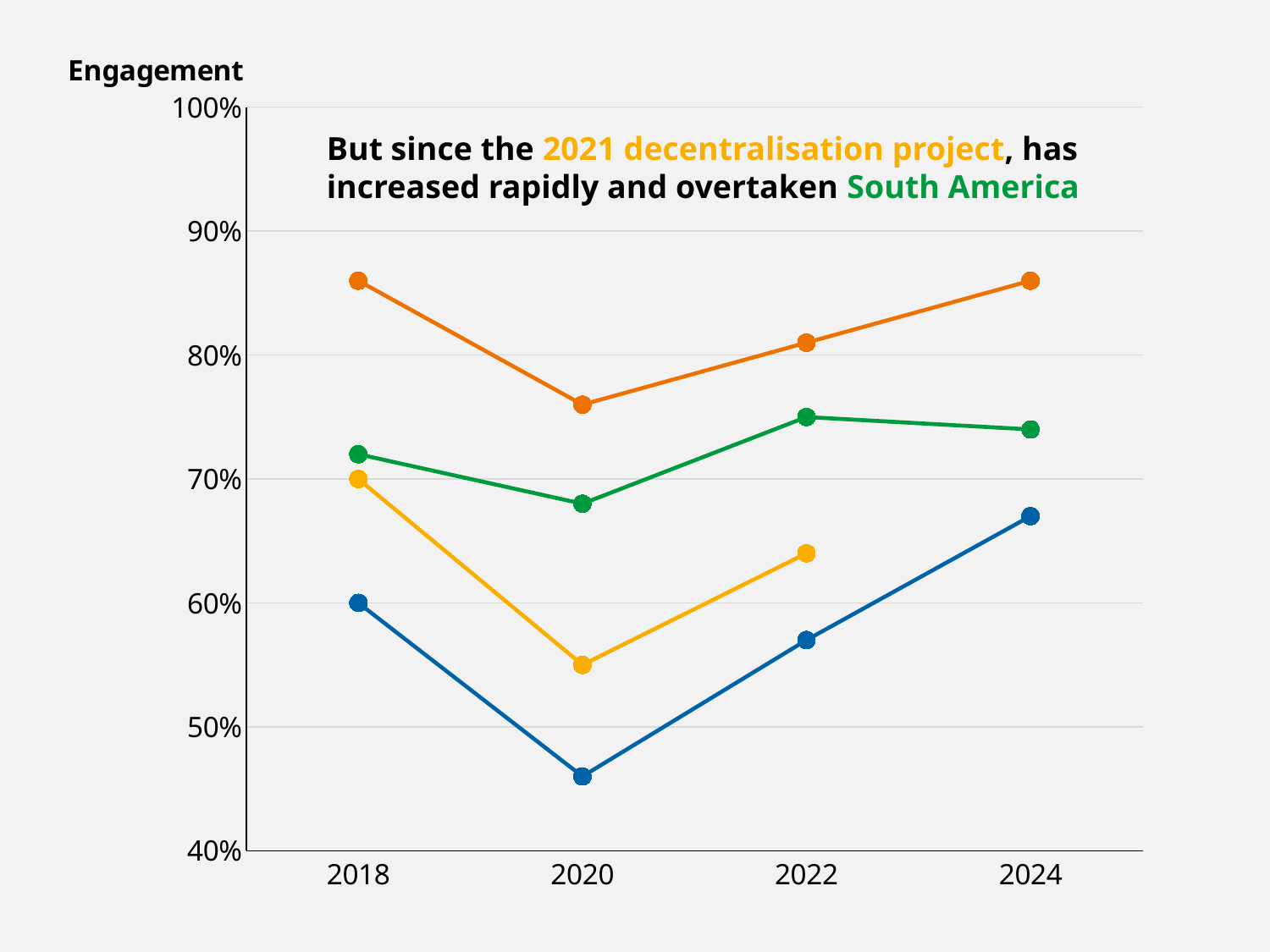
What is the value of the blue line in 2018? 60% In which year does the blue line reach its lowest value? 2020 Is the value of the green South America line in 2022 greater or less than 70%? greater Does the blue line rise or fall from 2020 to 2024? rise What is the title of the vertical axis? Engagement What type of chart is shown on the slide? line chart How many lines are plotted on the chart? 4 In 2024, which line is higher: the orange line or the green South America line? the orange line Is the value of the blue line in 2020 greater or less than 50%? less What is the value of the yellow line in 2018? 70% Is the value of the orange line in 2020 greater or less than 80%? less How many years are shown on the x axis of the chart? 4